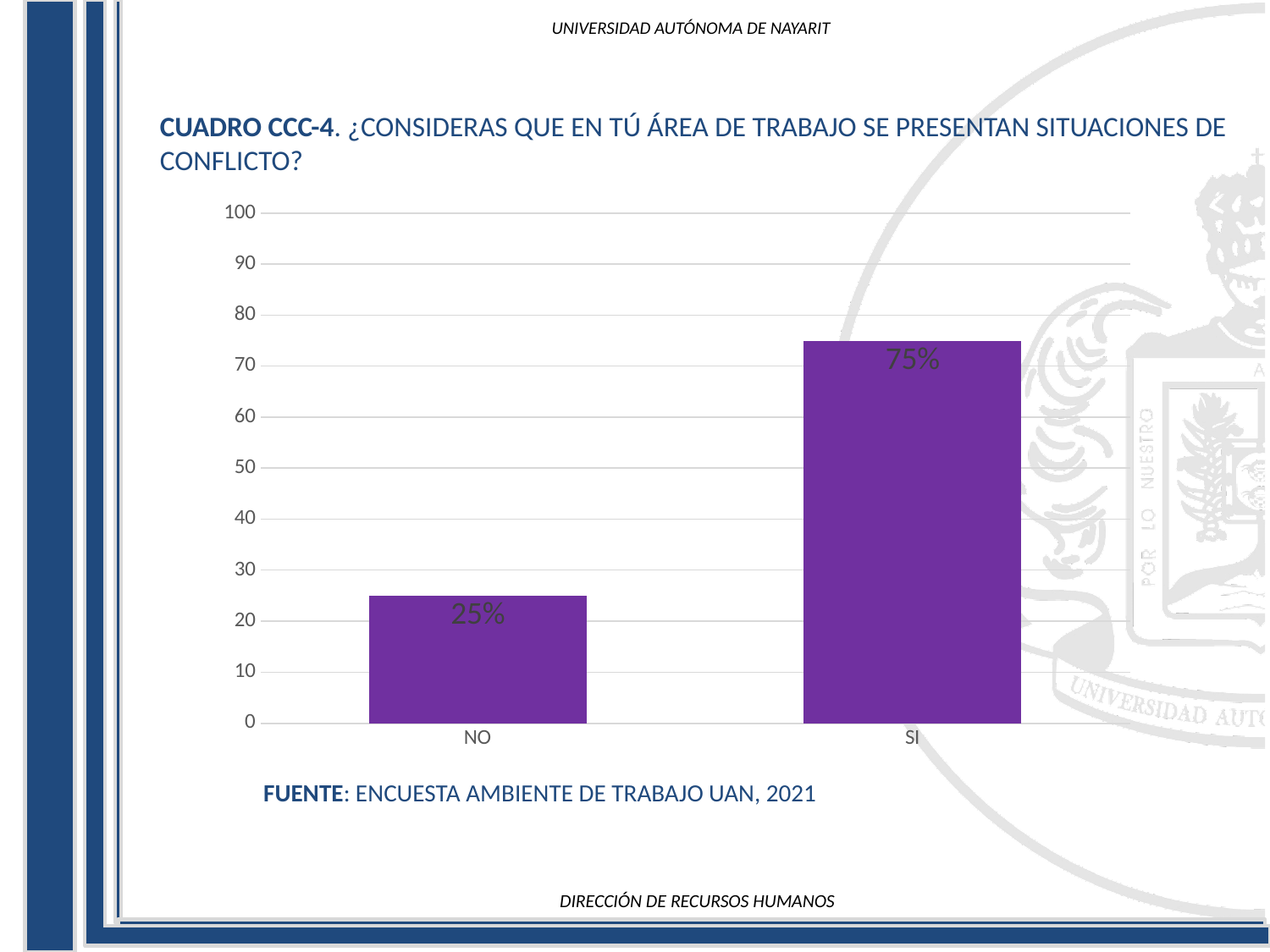
What is the difference between the values for SI and NO? 50% What is the value for SI? 75% Is the value for SI greater or less than 70? greater How many categories are shown on the x axis? 2 What source is cited below the chart? ENCUESTA AMBIENTE DE TRABAJO UAN, 2021 Which category has the lowest value? NO What is the maximum value shown on the y axis? 100 Which is larger, the value for NO or the value for SI? SI Is the value for NO greater or less than 30? less What kind of chart is shown on the slide? bar chart Which category has the highest value? SI What is the value for NO? 25%